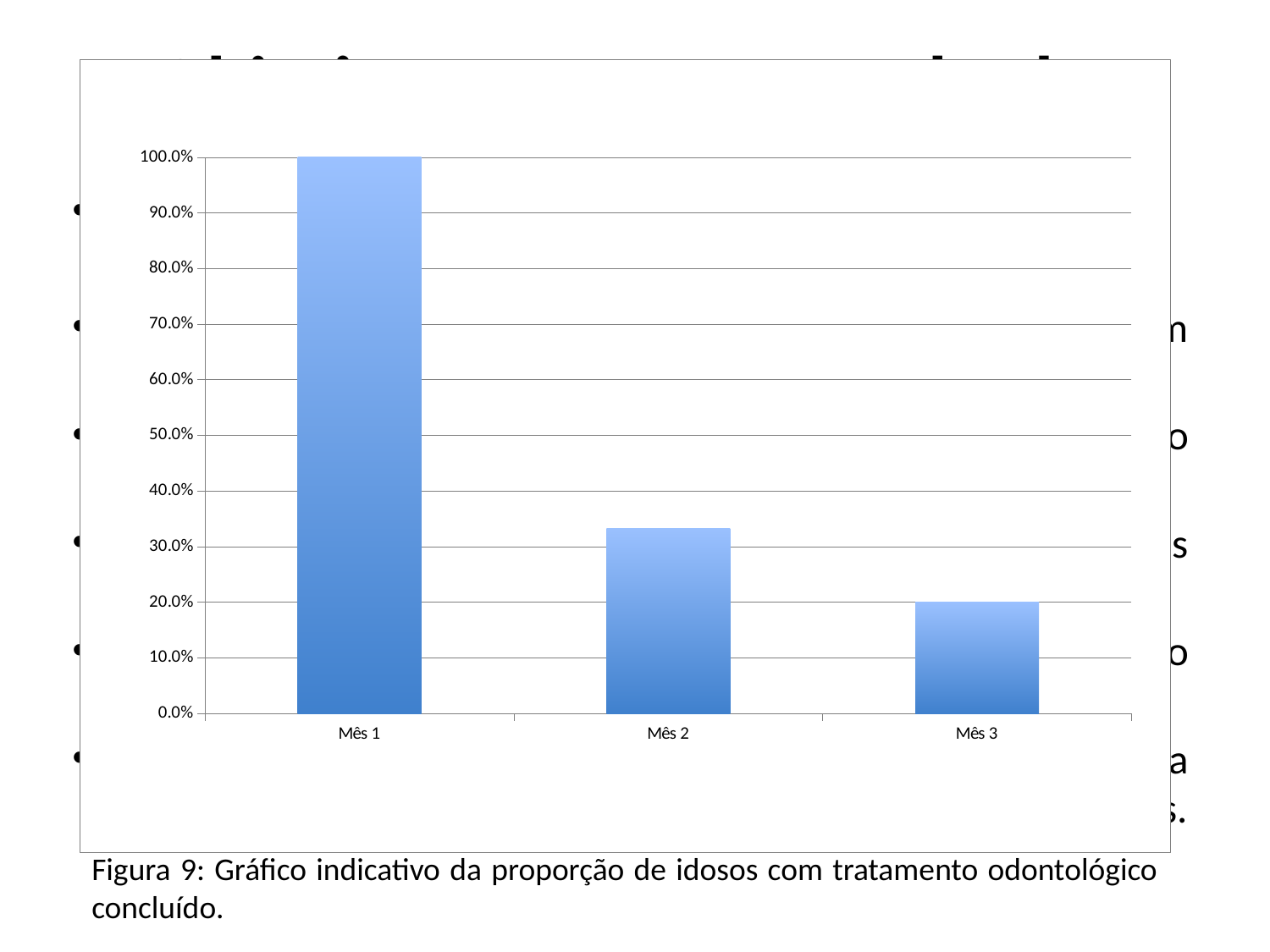
Which month has the lowest value in the chart? Mês 3 Which month has the highest value in the chart? Mês 1 What is the figure number given in the caption below the chart? Figura 9 What is the difference between the values for Mês 1 and Mês 3? 80.0% What is the value for Mês 3? 20.0% How many categories are plotted on the x axis of the chart? 3 What is the value for Mês 1? 100.0% Is the value for Mês 2 greater or less than 40.0%? less Which is larger, the value for Mês 2 or the value for Mês 3? Mês 2 What kind of chart is shown on the slide? bar chart Do the values rise or fall from Mês 1 to Mês 3? fall Is the value for Mês 2 greater or less than 30.0%? greater